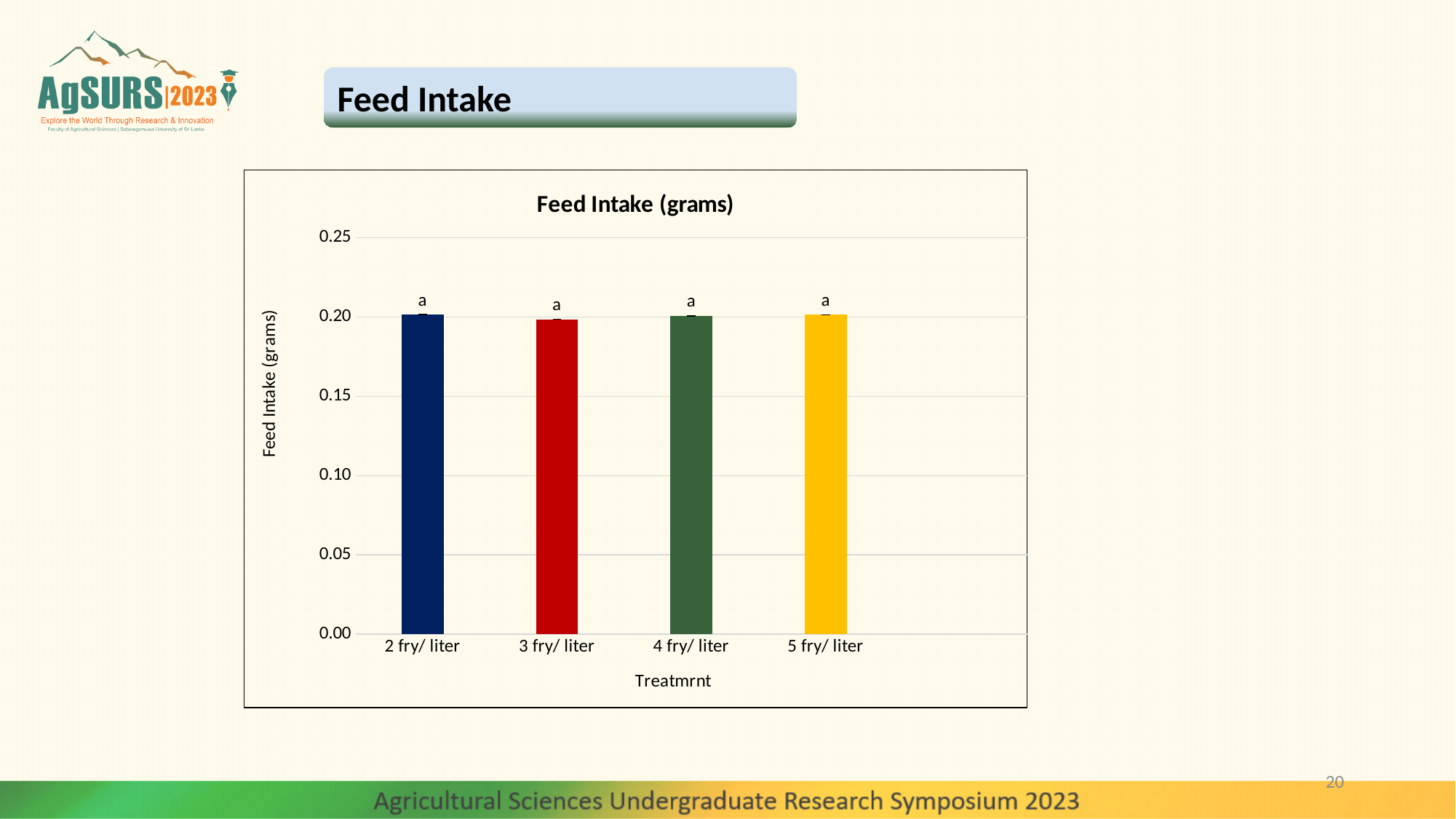
What is the label on the x axis of the chart? Treatmrnt Is the value for 5 fry/ liter greater or less than 0.25? less Is the value for 3 fry/ liter greater or less than 0.25? less Is the value for 4 fry/ liter greater or less than 0.15? greater What is the title of the chart? Feed Intake (grams) How many treatment categories are plotted on the x axis? 4 What kind of chart is shown on the slide? bar chart